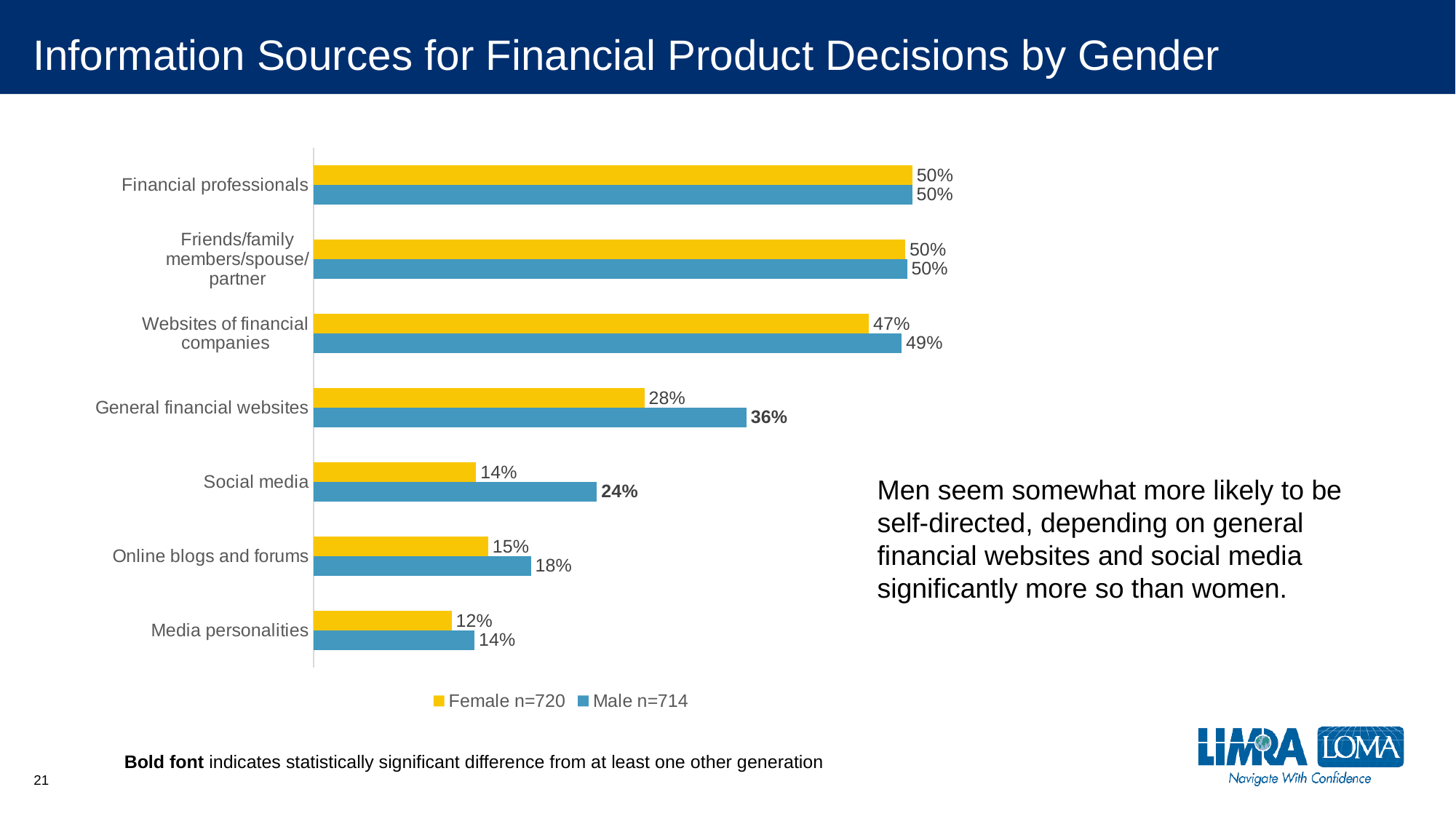
For online blogs and forums, which group has the higher value, females or males? Males How many information source categories are shown in the chart? 7 What is the difference between the male and female values for social media? 10% Which information source has the lowest value for females? Media personalities What is the sample size for the Male series shown in the legend? n=714 How many series does the legend list? 2 What is the value for females for media personalities? 12% What percentage of females use social media as an information source for financial product decisions? 14% What is the value for males for websites of financial companies? 49% What is the difference between the male and female values for general financial websites? 8% What kind of chart is shown on the slide? Bar chart What percentage of males use general financial websites as an information source? 36%